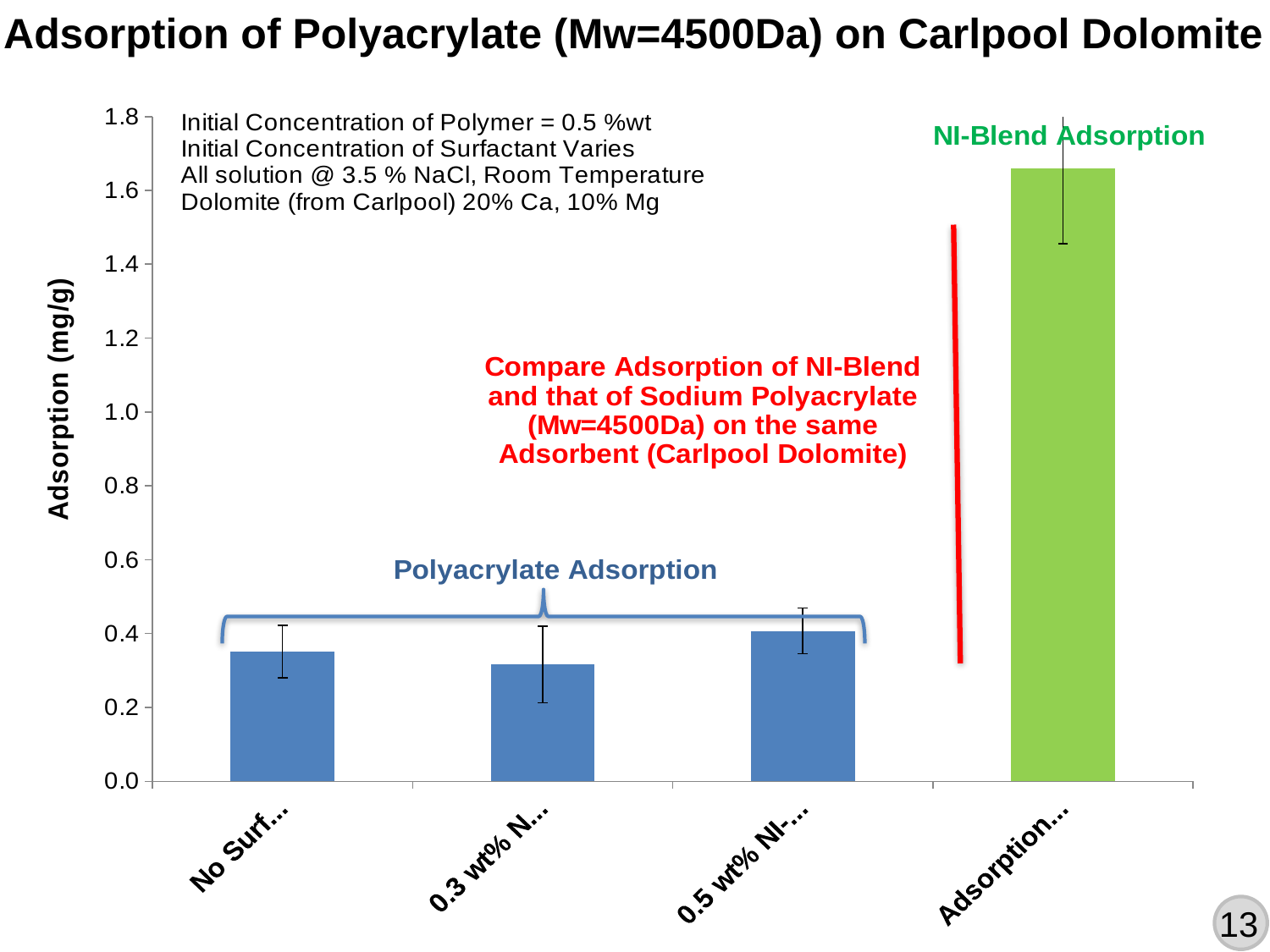
What is the title of the chart on the slide? Adsorption of Polyacrylate (Mw=4500Da) on Carlpool Dolomite Is the value for the "0.3 wt% N..." bar greater or less than 0.4? less What is the title of the y-axis? Adsorption (mg/g) What kind of chart is shown on the slide? bar chart Which is larger, the value for "No Surf..." or the value for the green "Adsorption..." bar? Adsorption... (green bar) Which bar has the highest adsorption value? Adsorption... (the green NI-Blend bar) Is the value for the "No Surf..." bar greater or less than 0.4? less Is the value for the green "Adsorption..." bar greater or less than 1.0? greater How many bars are plotted in the chart? 4 Which is larger, the value for "0.5 wt% NI-..." or the value for "0.3 wt% N..."? 0.5 wt% NI-...